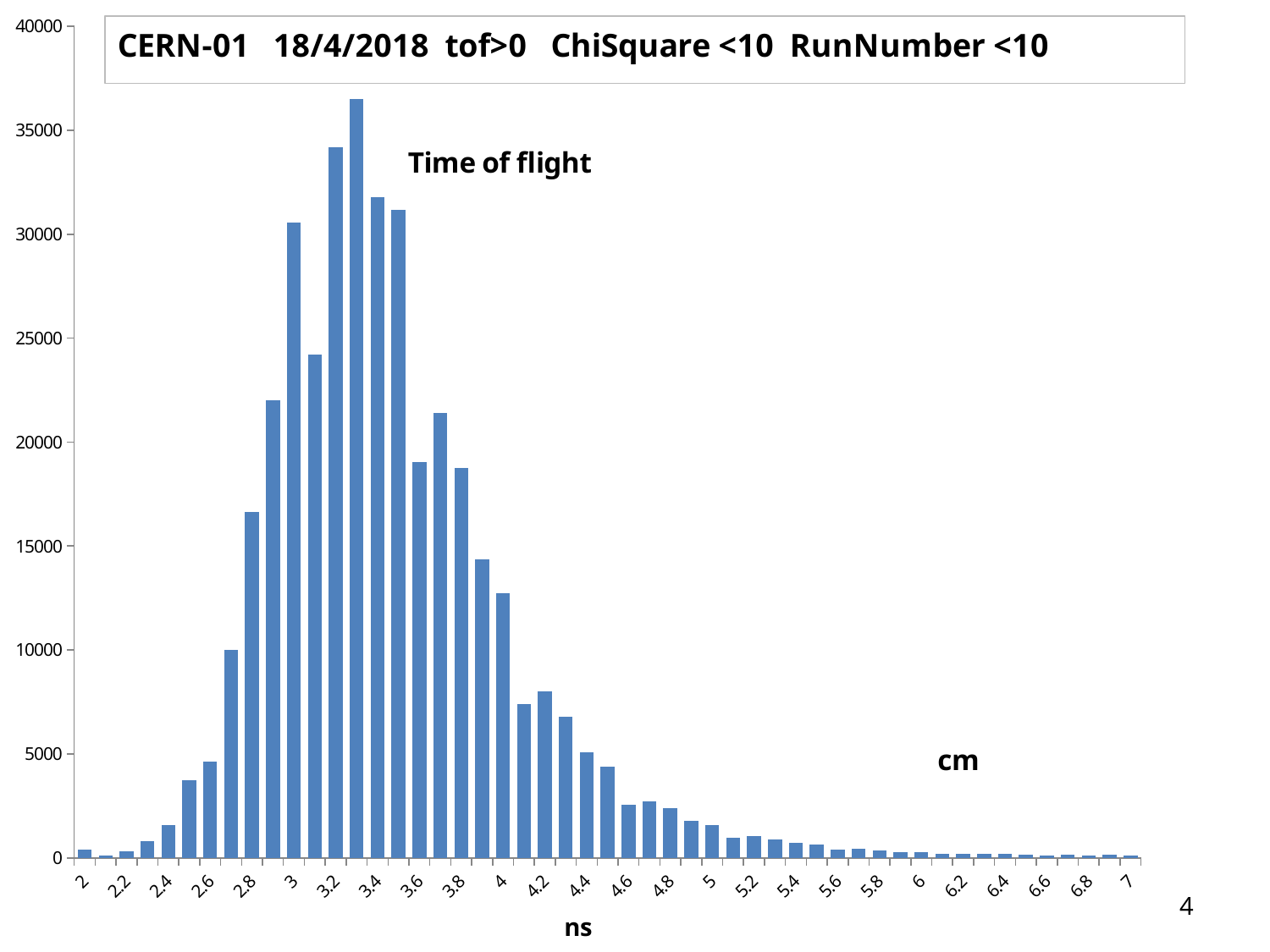
Which has the larger value, 3 or 3.6? 3 Is the value for 3.2 greater or less than 30000? greater Is the value for 2.8 greater or less than 15000? greater Which has the larger value, 4.2 or 4.4? 4.2 Is the value for 4.6 greater or less than 5000? less What unit label is shown below the x axis of the chart? ns Which has the larger value, 3.2 or 3.4? 3.2 What kind of chart is shown on the slide? bar chart Do the values rise or fall along the x axis from 3.4 to 5? fall What is the title shown in the box at the top of the chart? CERN-01 18/4/2018 tof>0 ChiSquare <10 RunNumber <10